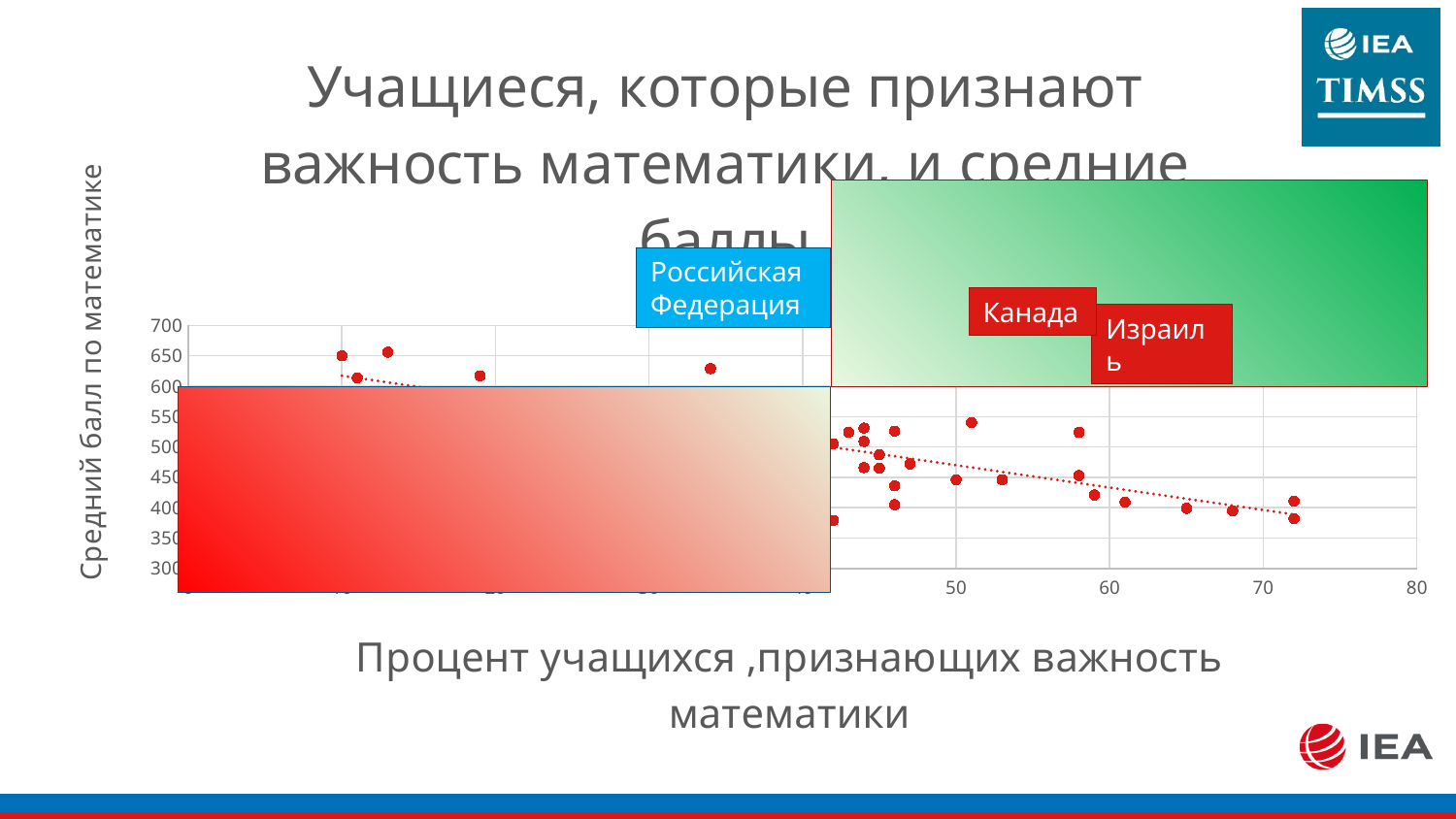
What is the label of the vertical axis of the chart? Средний балл по математике Is the value of the lowest plotted point on the chart greater or less than 400? less Does the dotted trend line rise or fall as the percentage of students on the x axis increases? fall Is the value of the highest plotted point on the chart greater or less than 600? greater Is the value of the point plotted near 51 on the x axis greater or less than 500? greater What is the label of the horizontal axis of the chart? Процент учащихся, признающих важность математики What kind of chart is shown on the slide? scatter chart